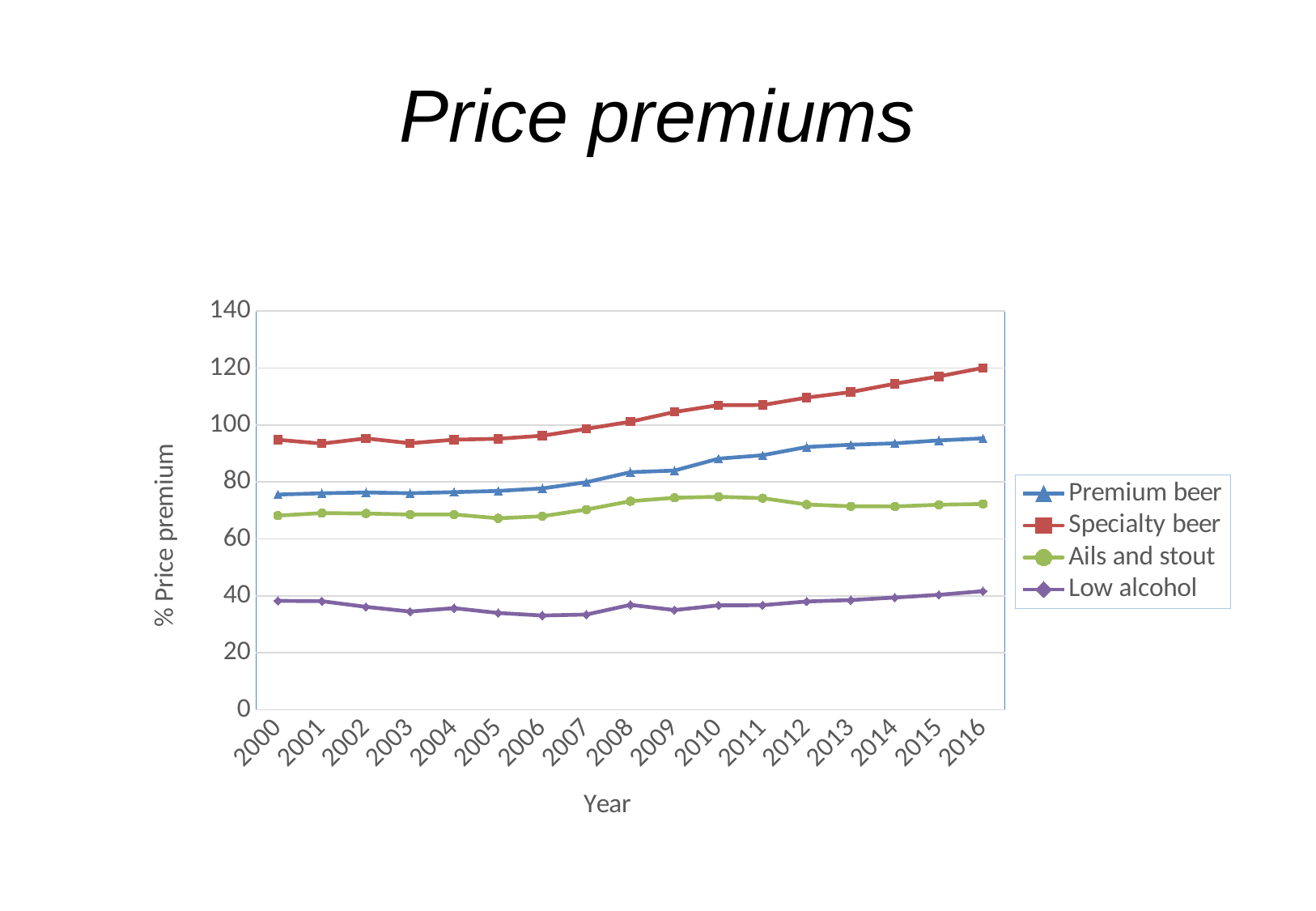
What is the label of the y axis? % Price premium Which series has the lowest price premium across all years? Low alcohol Does the Specialty beer series rise or fall from 2006 to 2016? rise Which is larger in 2010: Premium beer or Ails and stout? Premium beer What kind of chart is shown on the slide? line chart Is the value for Premium beer in 2000 greater or less than 80? less How many years are shown on the x axis? 17 How many series does the legend list? 4 Is the value for Specialty beer in 2016 greater or less than 100? greater What is the title of the chart? Price premiums Which series has the highest price premium in 2016? Specialty beer Is the value for Low alcohol in 2006 greater or less than 40? less